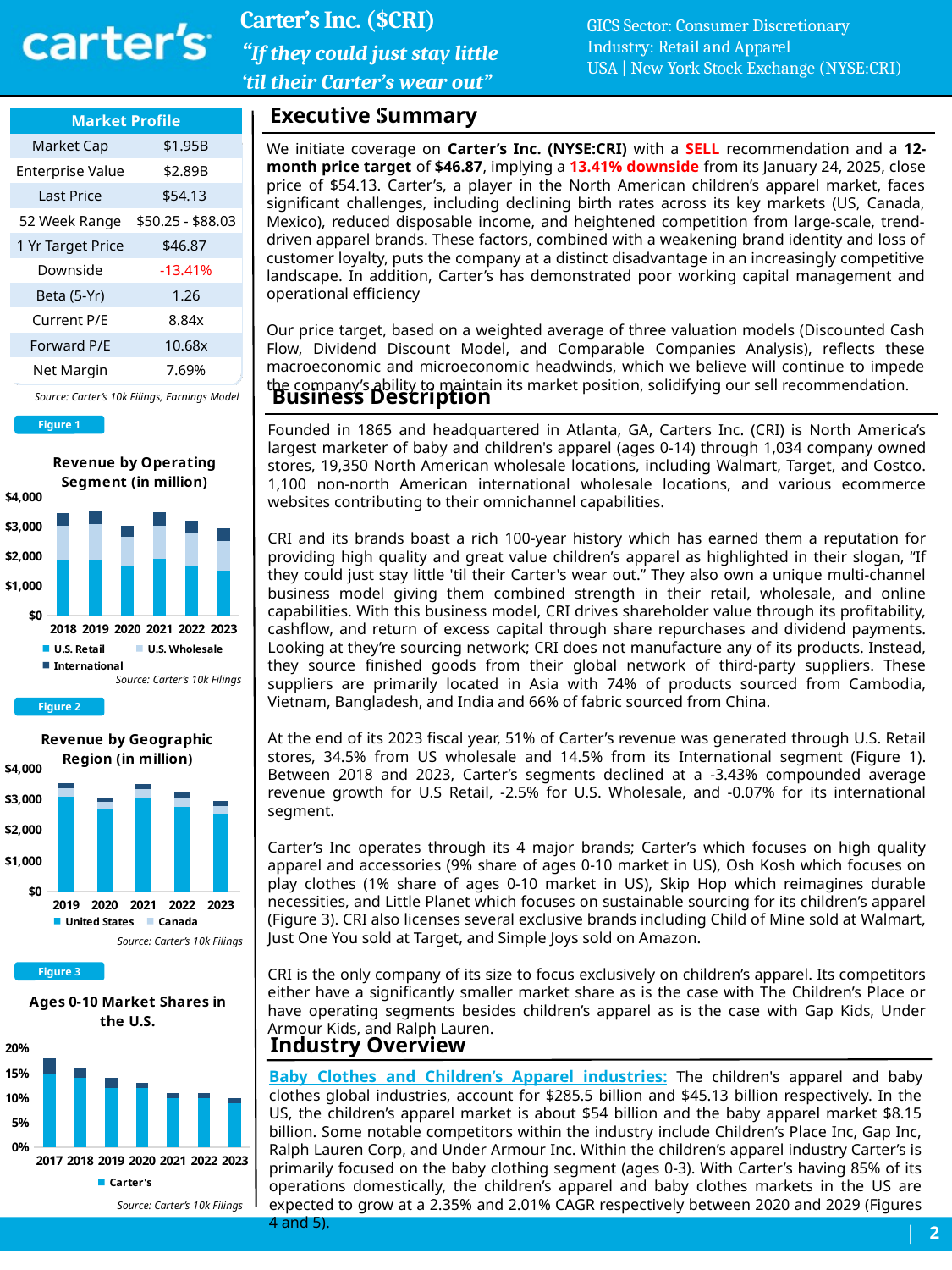
What type of chart is the 'Revenue by Operating Segment (in million)' chart (Figure 1)? Stacked bar chart How many series does the legend of the 'Revenue by Geographic Region (in million)' chart (Figure 2) list? 2 In the 'Revenue by Operating Segment (in million)' chart, is the total revenue for 2019 greater or less than $3,000? greater In the 'Revenue by Geographic Region (in million)' chart, is the United States value for 2020 greater or less than $3,000? less In the 'Revenue by Operating Segment (in million)' chart, which year has the larger total bar, 2019 or 2023? 2019 In the 'Revenue by Operating Segment (in million)' chart, is the U.S. Retail value for 2018 greater or less than $2,000? less How many years are shown on the x axis of the 'Revenue by Operating Segment (in million)' chart? 6 How many years are shown on the x axis of the 'Revenue by Geographic Region (in million)' chart? 5 How many years are shown on the x axis of the 'Ages 0-10 Market Shares in the U.S.' chart? 7 In the 'Ages 0-10 Market Shares in the U.S.' chart (Figure 3), do Carter's values rise or fall from 2017 to 2023? fall How many series does the legend of the 'Revenue by Operating Segment (in million)' chart list? 3